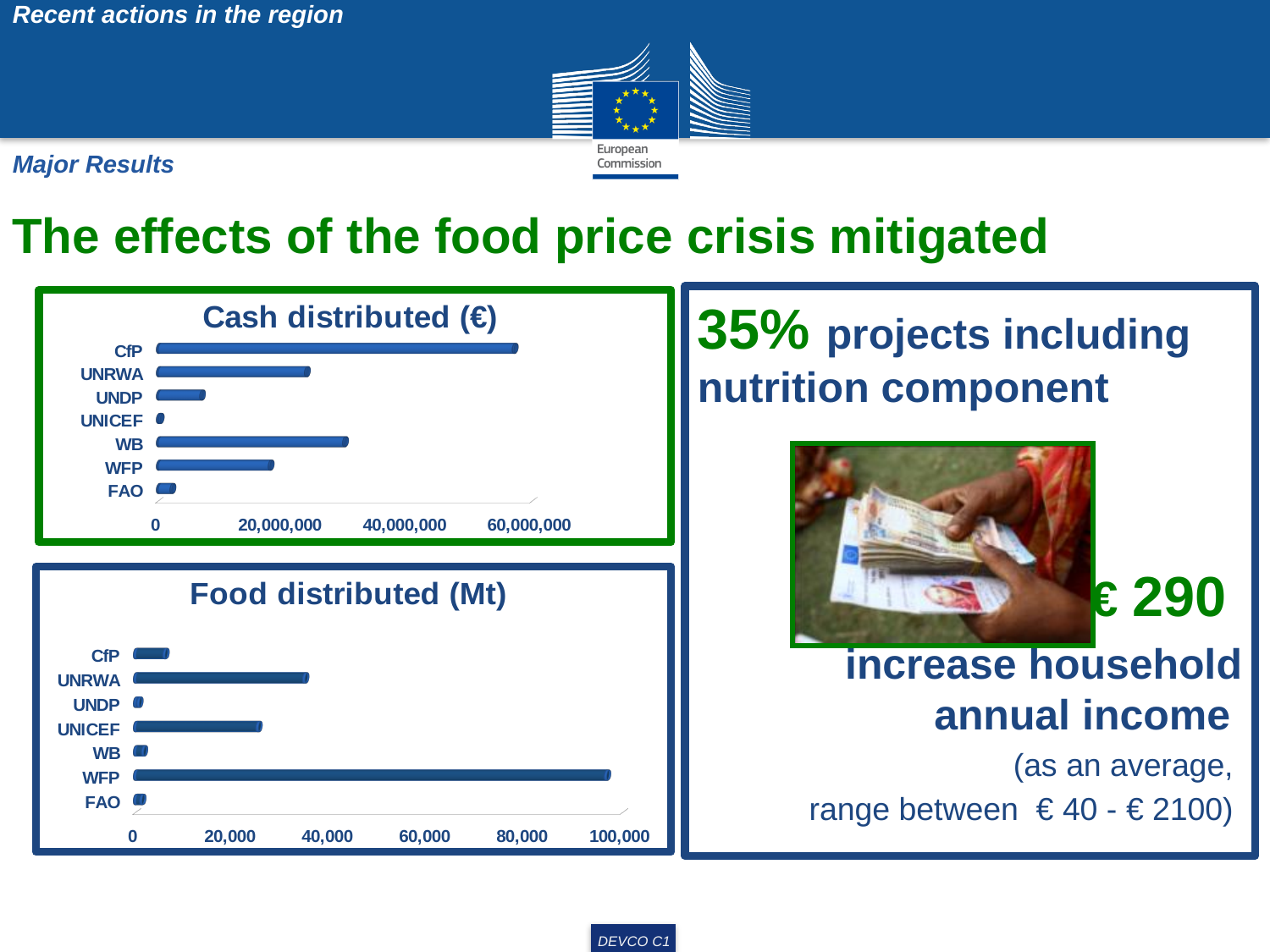
In the "Cash distributed (€)" chart, which is larger, the value for WB or the value for UNRWA? WB In the "Food distributed (Mt)" chart, is the value for CfP greater or less than 20,000? less In the "Food distributed (Mt)" chart, which is larger, the value for UNRWA or the value for UNICEF? UNRWA In the "Food distributed (Mt)" chart, which organisation has the highest value? WFP What is the title of the lower chart on the slide? Food distributed (Mt) In the "Cash distributed (€)" chart, is the value for UNDP greater or less than 20,000,000? less What kind of chart is the "Food distributed (Mt)" chart? Bar chart In the "Cash distributed (€)" chart, is the value for CfP greater or less than 40,000,000? greater In the "Cash distributed (€)" chart, which organisation has the lowest value? UNICEF How many organisations are shown in the "Cash distributed (€)" chart? 7 In the "Cash distributed (€)" chart, which organisation has the highest value? CfP